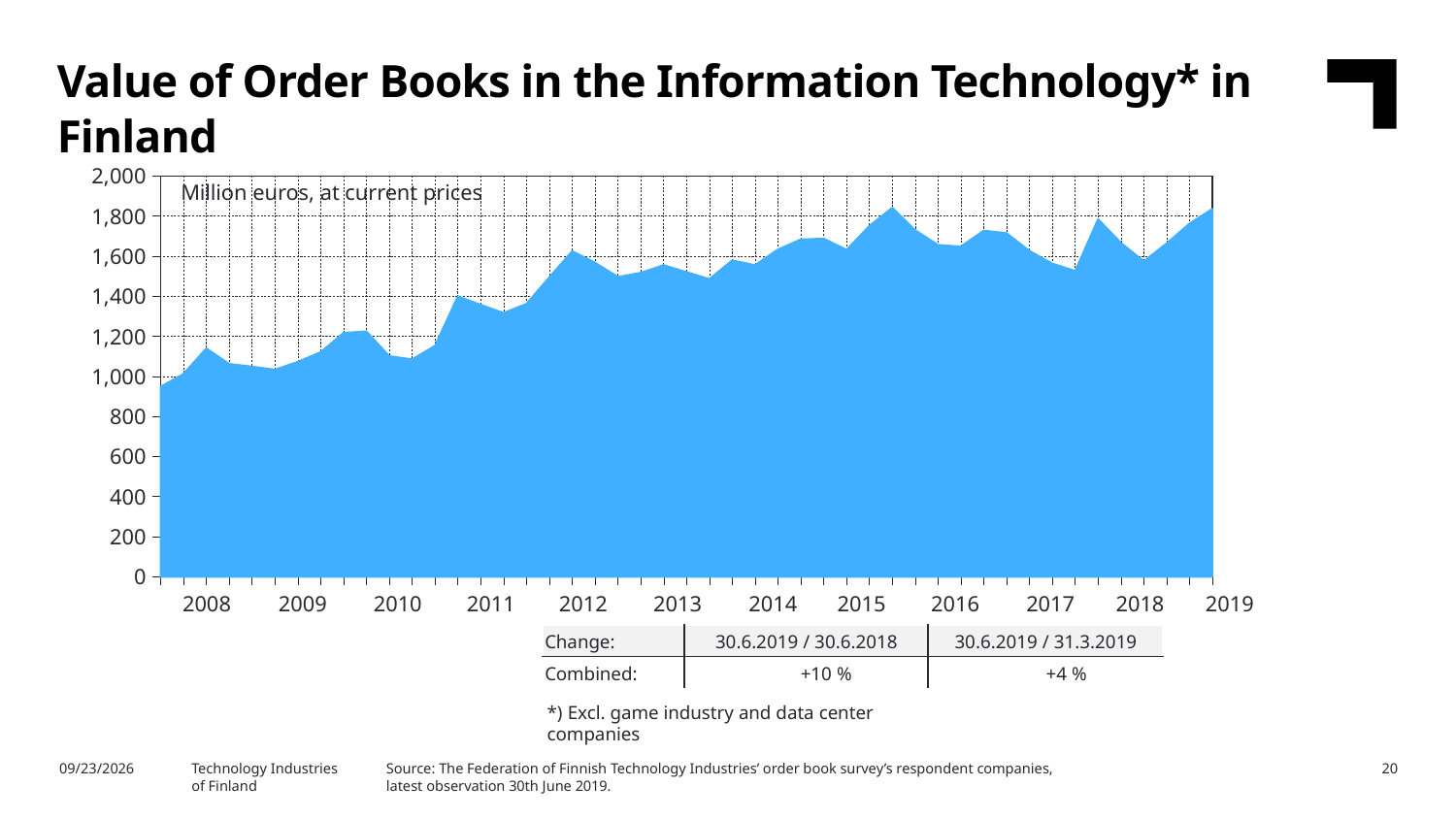
Is the value at the 2018 tick greater or less than 1,400? greater According to the table below the chart, what is the combined change for 30.6.2019 / 30.6.2018? +10 % Is the value at the 2019 tick larger or smaller than the value at the 2008 tick? larger What kind of chart is shown on the slide? Area chart Is the value at the 2012 tick greater or less than 1,400? greater Is the value at the 2019 tick greater or less than 1,600? greater What is the title of the chart on the slide? Value of Order Books in the Information Technology* in Finland Overall, do the values rise or fall from 2008 to 2019? rise In what unit are the values on the chart expressed, according to the label inside the plot area? Million euros, at current prices